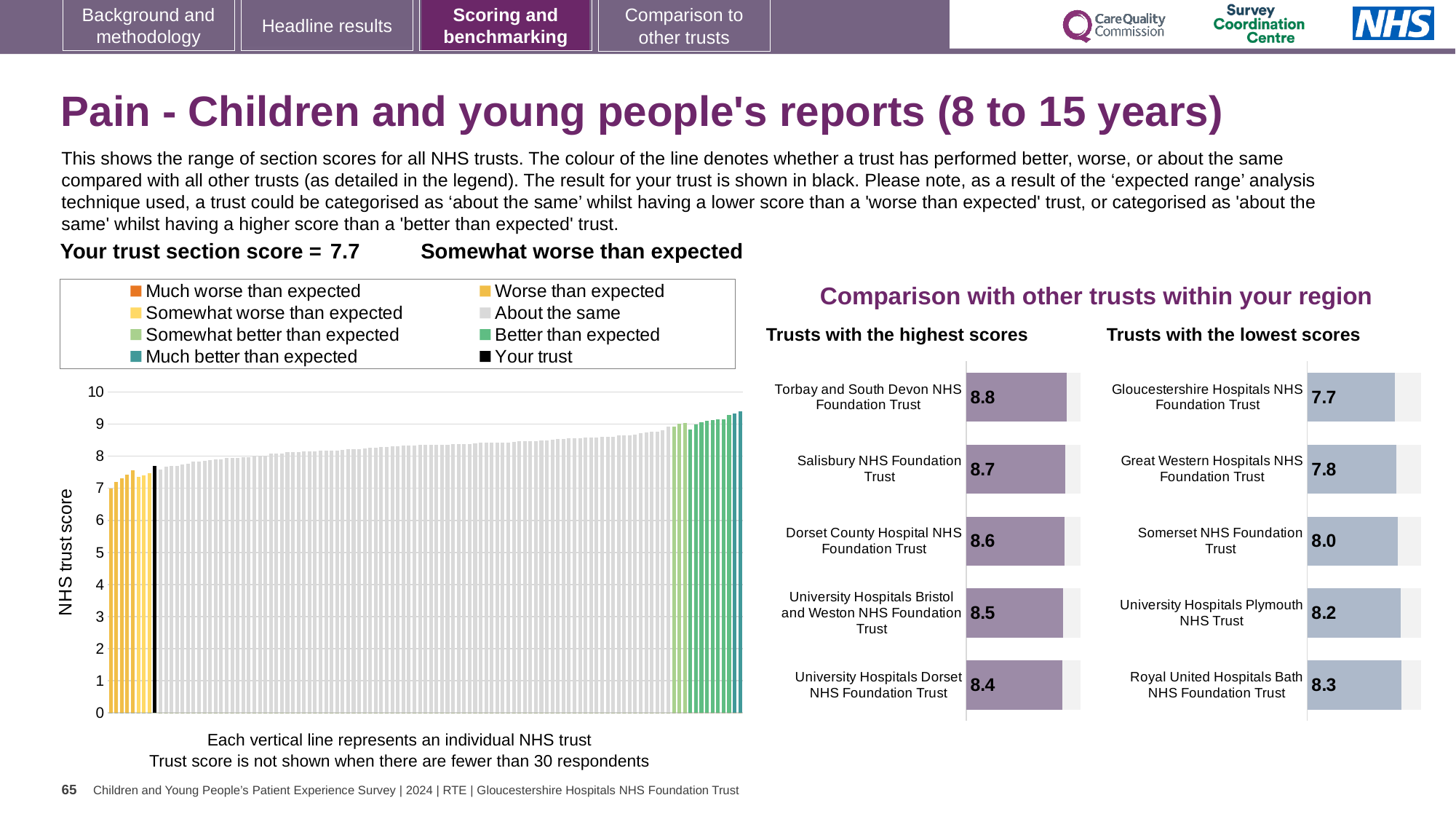
What kind of chart is the 'NHS trust score' chart on the left of the slide? Bar chart In the 'Trusts with the highest scores' chart, what is the score for Torbay and South Devon NHS Foundation Trust? 8.8 In the 'Trusts with the lowest scores' chart, which trust has the highest score shown? Royal United Hospitals Bath NHS Foundation Trust In the 'NHS trust score' chart on the left, is the value of the black 'Your trust' bar greater or less than 8? less How many entries does the legend of the 'NHS trust score' chart on the left list? 8 In the 'Trusts with the lowest scores' chart, which has the larger score: Great Western Hospitals NHS Foundation Trust or University Hospitals Plymouth NHS Trust? University Hospitals Plymouth NHS Trust In the 'Trusts with the lowest scores' chart, what is the score for Somerset NHS Foundation Trust? 8.0 In the 'Trusts with the lowest scores' chart, what is the difference between the scores of Royal United Hospitals Bath NHS Foundation Trust and Gloucestershire Hospitals NHS Foundation Trust? 0.6 In the 'Trusts with the highest scores' chart, which trust has the lowest score shown? University Hospitals Dorset NHS Foundation Trust How many trusts are listed in the 'Trusts with the lowest scores' chart? 5 In the 'NHS trust score' chart on the left, do the bar values rise or fall from left to right? Rise In the 'Trusts with the highest scores' chart, what is the difference between the scores of Torbay and South Devon NHS Foundation Trust and University Hospitals Dorset NHS Foundation Trust? 0.4